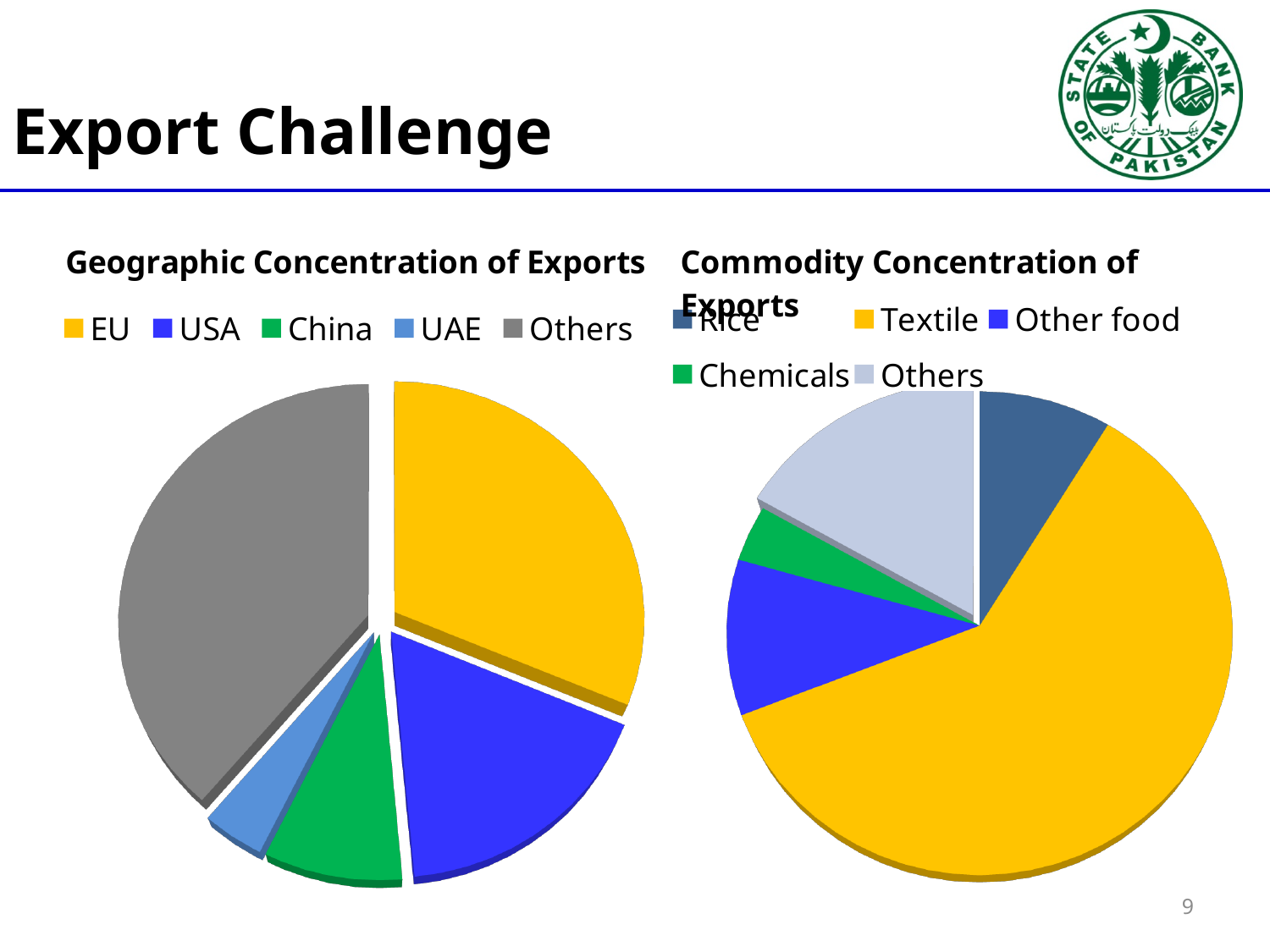
How many entries does the legend of the Commodity Concentration of Exports chart list? 5 In the Geographic Concentration of Exports chart, which slice is larger, EU or USA? EU What kind of chart is the Commodity Concentration of Exports chart? Pie chart In the Commodity Concentration of Exports chart, which category has the largest slice? Textile What kind of chart is the Geographic Concentration of Exports chart? Pie chart In the Commodity Concentration of Exports chart, which slice is larger, Rice or Other food? Other food In the Geographic Concentration of Exports chart, which category has the largest slice? Others In the Commodity Concentration of Exports chart, which category has the smallest slice? Chemicals In the Geographic Concentration of Exports chart, which slice is larger, USA or China? USA In the Geographic Concentration of Exports chart, which category has the smallest slice? UAE In the Geographic Concentration of Exports chart, which colour represents China? Green How many categories does the Geographic Concentration of Exports pie chart show? 5